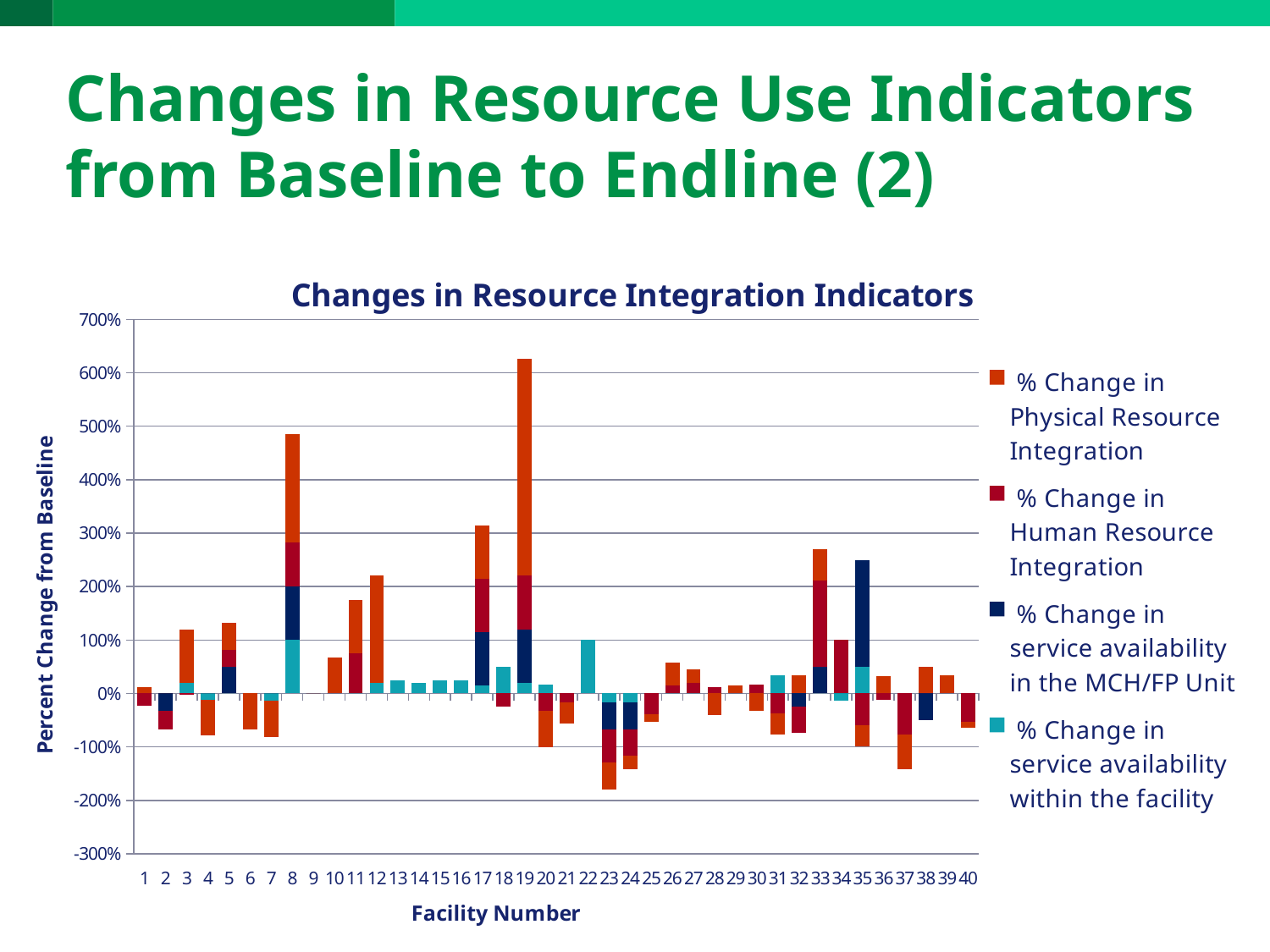
How many facilities are shown along the x axis? 40 What kind of chart is shown on the slide? Stacked bar chart Is the top of the stacked bar for facility 33 greater or less than 200%? greater How many series does the legend list? 4 Which facility number has the stacked bar extending furthest below zero? 23 Which has the taller stacked bar above zero, facility 8 or facility 12? Facility 8 What is the title of the chart? Changes in Resource Integration Indicators What is the label of the y axis? Percent Change from Baseline Is the bottom of the stacked bar for facility 23 greater or less than -100%? less Is the top of the stacked bar for facility 8 greater or less than 400%? greater Which facility number has the tallest stacked bar above zero? 19